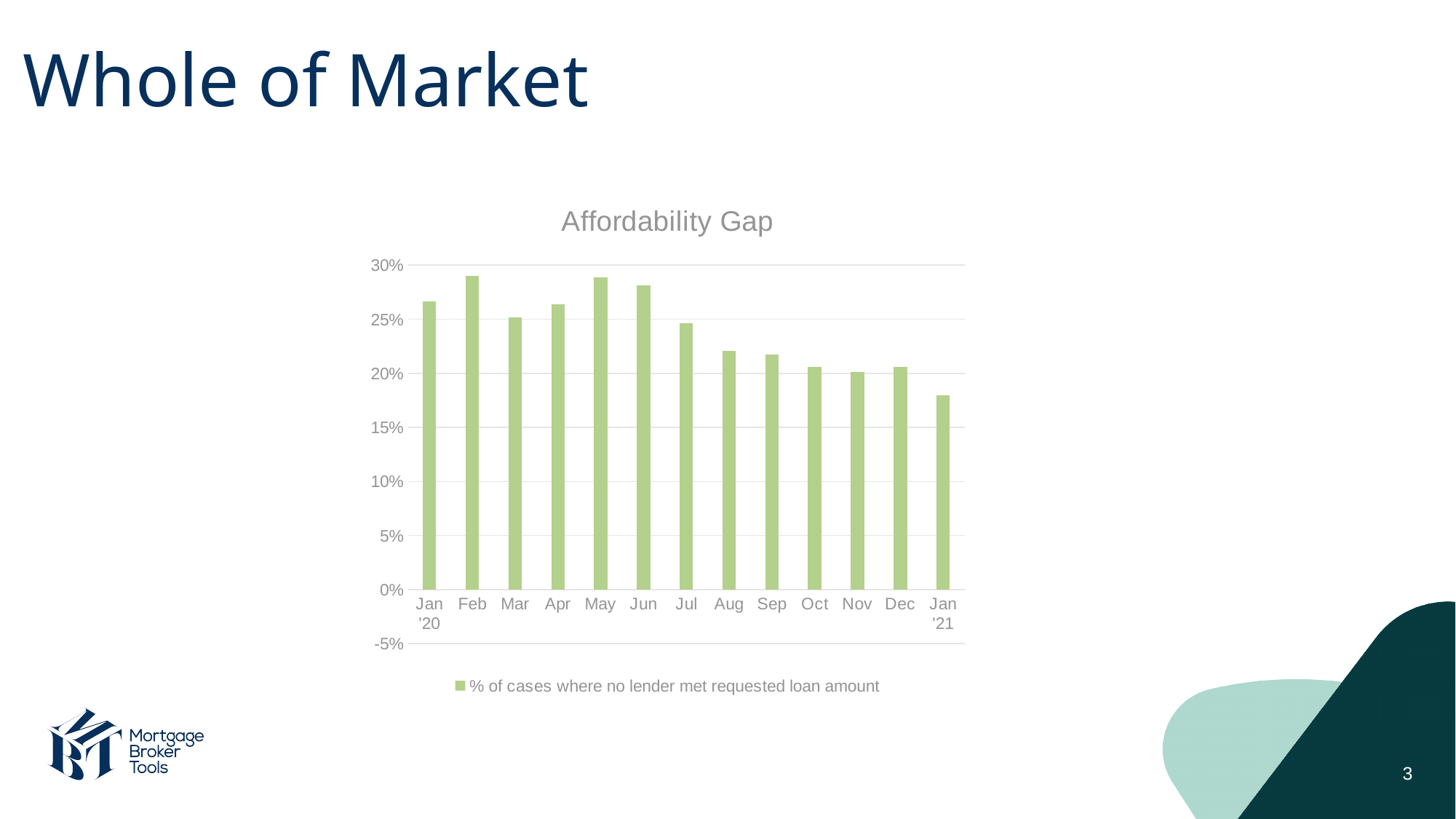
How many series does the legend list? 1 Which month has the lowest value? Jan '21 Is the value for Jun greater or less than 25%? greater What is the title of the chart? Affordability Gap What series does the legend list? % of cases where no lender met requested loan amount Is the value for Jan '21 greater or less than 20%? less How many months (bars) are plotted on the chart? 13 What kind of chart is shown on the slide? Bar chart Which is larger, the value for Feb or the value for Jan '21? Feb Is the value for Jul greater or less than 25%? less Do the values generally rise or fall from Jan '20 to Jan '21? Fall